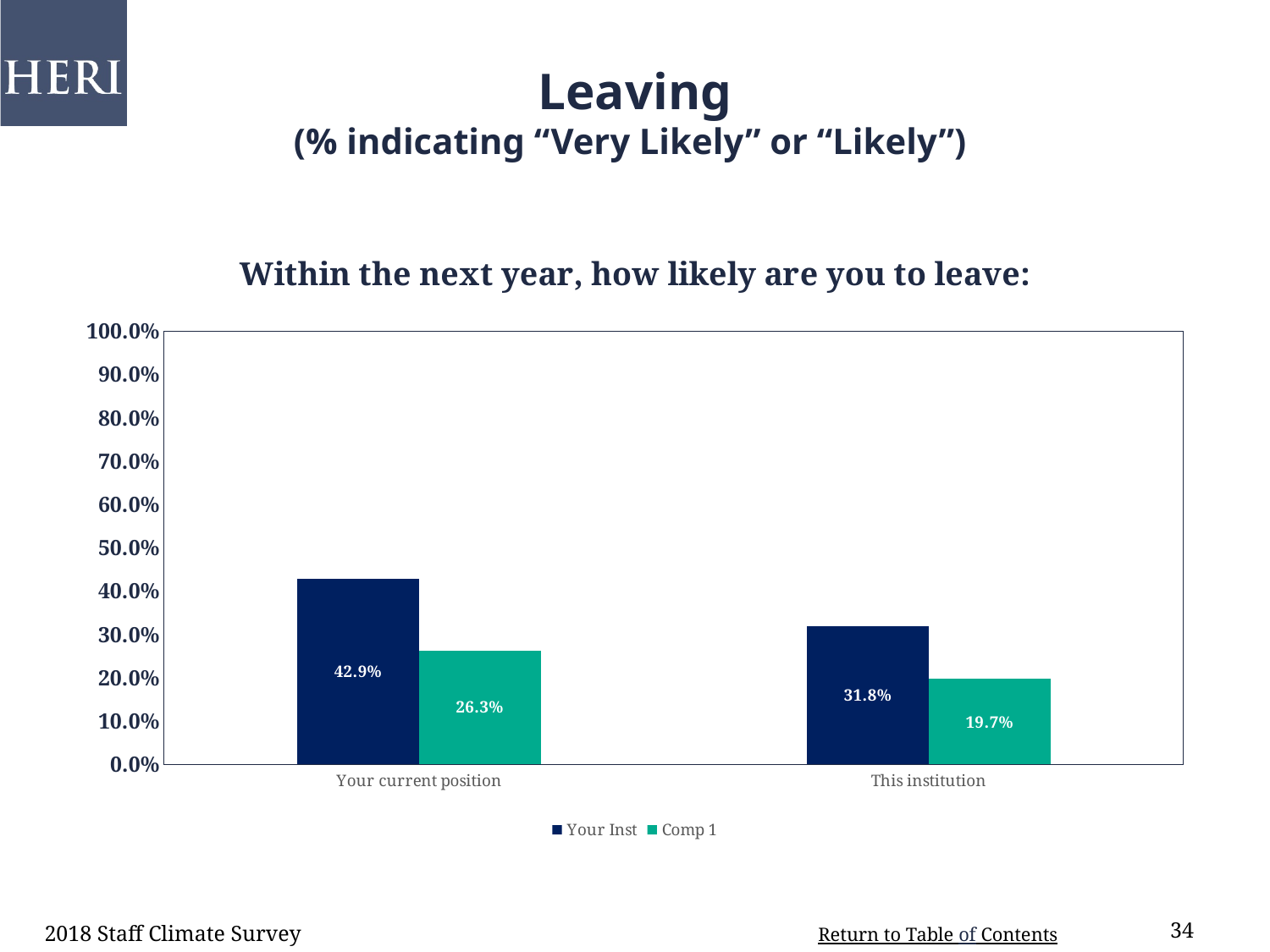
What is the value for Comp 1 for "This institution"? 19.7% What is the difference between Your Inst and Comp 1 for "Your current position"? 16.6% Which is larger for "This institution": Your Inst or Comp 1? Your Inst What is the value for Your Inst for "This institution"? 31.8% Which category has the lowest Comp 1 value? This institution How many series does the legend list? 2 What kind of chart is shown on the slide? Bar chart Is the Your Inst value for "Your current position" greater or less than 40.0%? greater Which category has the highest Your Inst value? Your current position What is the difference between Your Inst and Comp 1 for "This institution"? 12.1% How many categories are shown on the x axis? 2 What is the value for Your Inst for "Your current position"? 42.9%